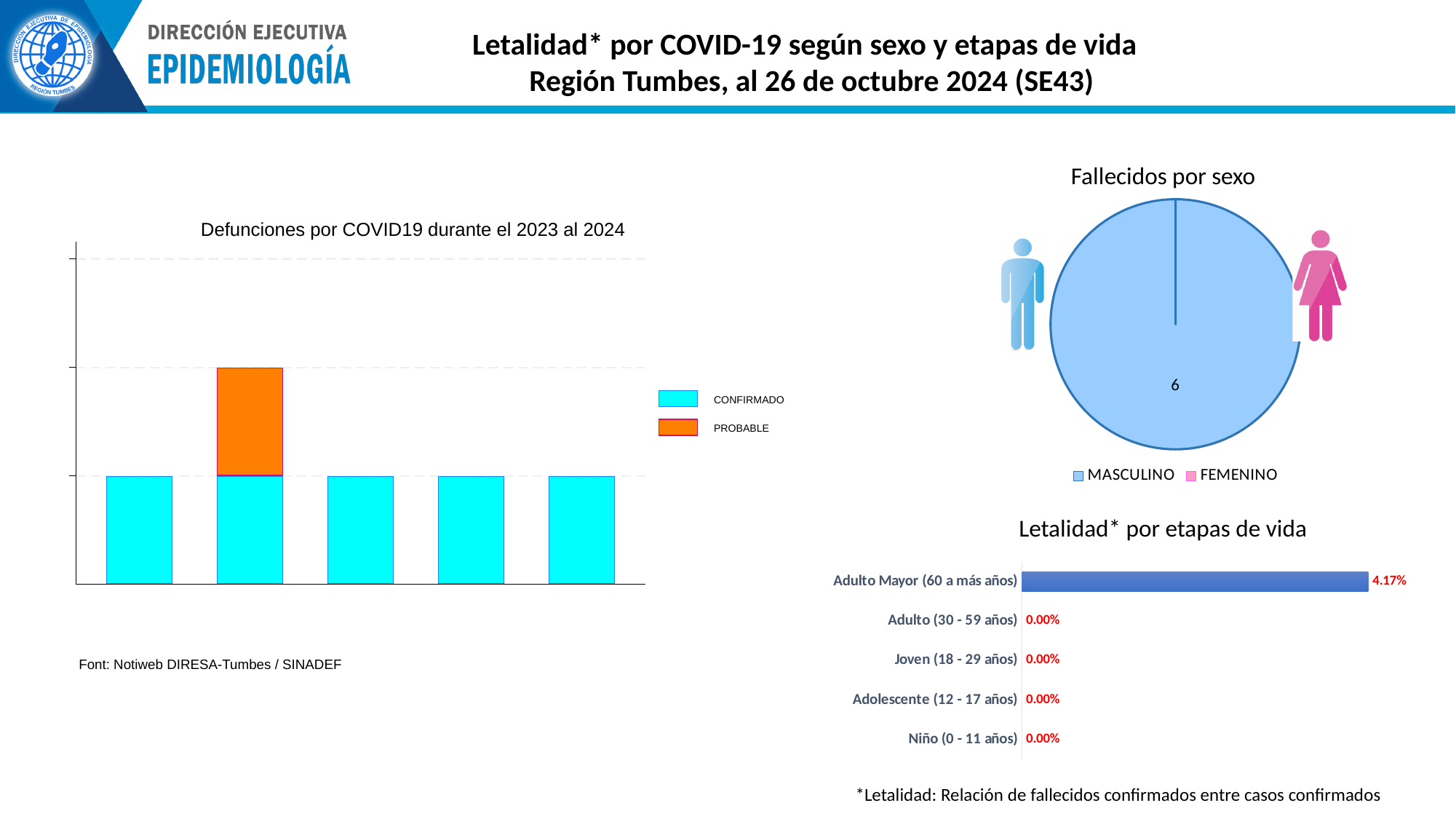
How many entries does the legend of the 'Fallecidos por sexo' chart list? 2 In the 'Letalidad* por etapas de vida' chart, what is the value for Adulto Mayor (60 a más años)? 4.17% In the 'Fallecidos por sexo' chart, what value is shown for MASCULINO? 6 What kind of chart is 'Fallecidos por sexo'? pie chart In the 'Letalidad* por etapas de vida' chart, which category has the highest value? Adulto Mayor (60 a más años) In the 'Defunciones por COVID19 durante el 2023 al 2024' chart, which series is shown in orange? PROBABLE In the 'Letalidad* por etapas de vida' chart, what is the difference between the value for Adulto Mayor (60 a más años) and the value for Joven (18 - 29 años)? 4.17% In the 'Letalidad* por etapas de vida' chart, how many age-group categories are shown? 5 How many bars are plotted in the 'Defunciones por COVID19 durante el 2023 al 2024' chart? 5 What kind of chart is 'Letalidad* por etapas de vida'? bar chart How many series does the legend of the 'Defunciones por COVID19 durante el 2023 al 2024' chart list? 2 In the 'Letalidad* por etapas de vida' chart, what is the value for Adulto (30 - 59 años)? 0.00%